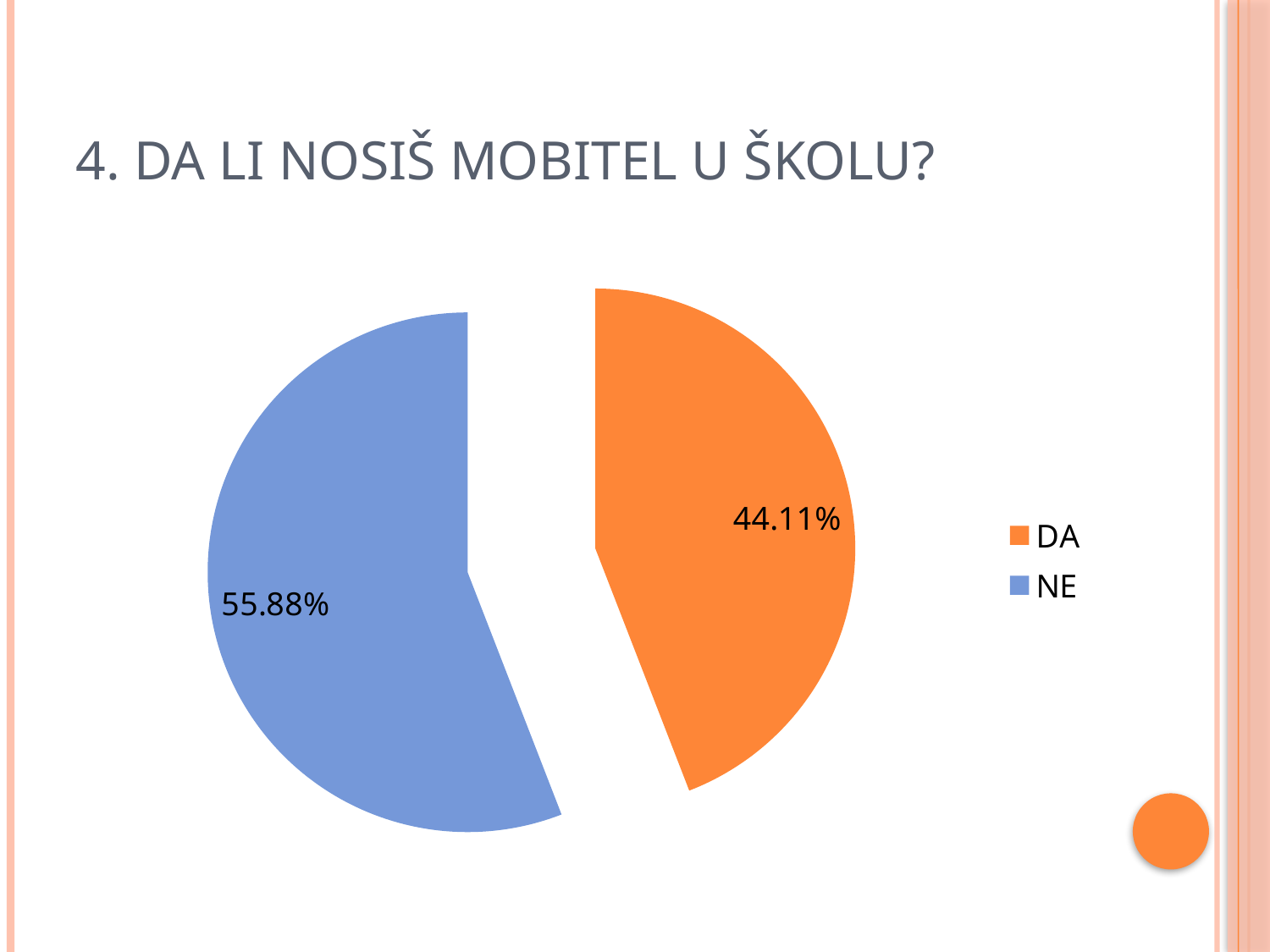
What kind of chart is shown on the slide? pie chart Which slice of the pie is the largest? NE Which slice of the pie is the smallest? DA Which is larger, the DA slice or the NE slice? NE How many entries does the legend list? 2 What is the title of the slide above the chart? 4. DA LI NOSIŠ MOBITEL U ŠKOLU? What is the difference in percentage points between the NE slice and the DA slice? 11.77 What percentage of the pie is labelled NE? 55.88% How many slices does the pie chart have? 2 What colour is the DA slice? orange What percentage of the pie is labelled DA? 44.11%